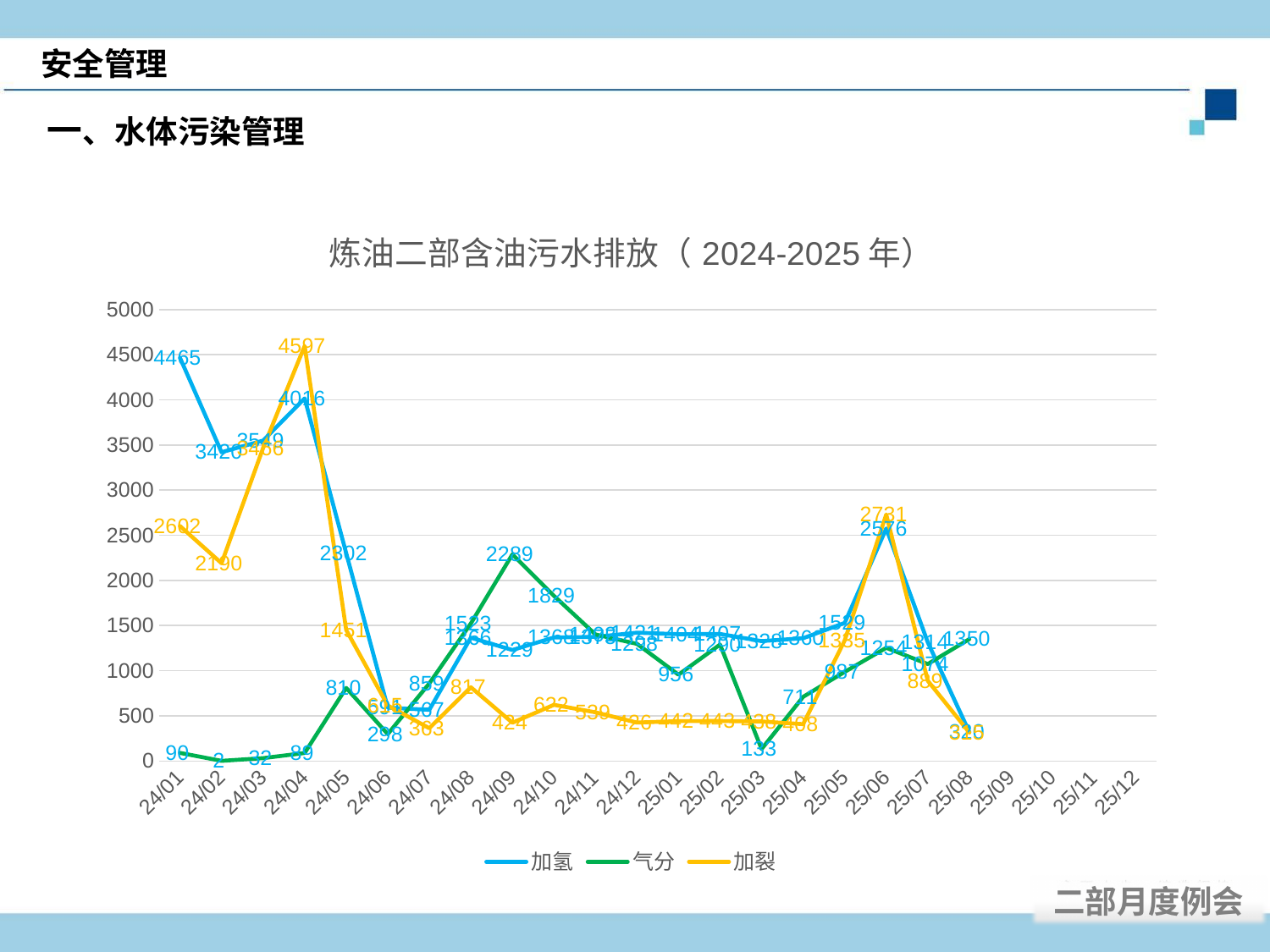
What is the title of the chart? 炼油二部含油污水排放（2024-2025年） How many series does the legend list? 3 What is the value for 气分 in 24/09? 2289 In which month does 气分 have its lowest value? 24/02 What kind of chart is shown on the slide? line chart In 25/06, which series has the larger value, 加裂 or 加氢? 加裂 What is the value for 气分 in 25/03? 133 What is the value for 加氢 in 24/01? 4465 In which month does 加裂 reach its highest value? 24/04 What is the value for 加裂 in 24/04? 4597 What is the difference between the 加氢 values in 24/01 and 24/04? 449 Is the value for 加氢 in 24/05 greater or less than 2000? greater